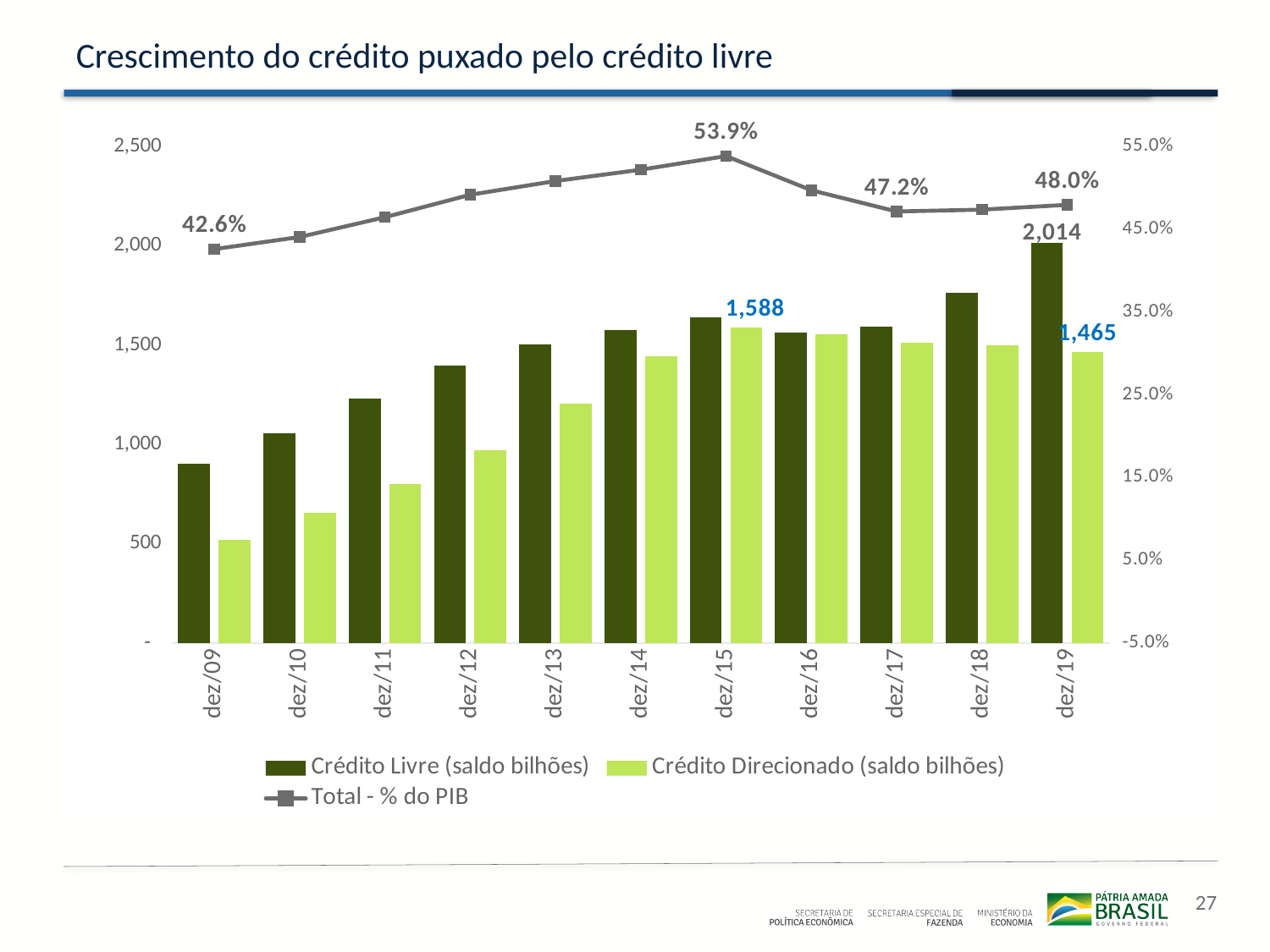
What is the Total - % do PIB value in dez/17? 47.2% In dez/19, which is larger: Crédito Livre or Crédito Direcionado? Crédito Livre What is the value of Crédito Livre (saldo bilhões) in dez/19? 2,014 What is the Total - % do PIB value in dez/09? 42.6% In which period does Total - % do PIB reach its highest value? dez/15 What is the value of Crédito Direcionado (saldo bilhões) in dez/15? 1,588 What kind of chart is shown on the slide? Combination bar and line chart What is the value of Crédito Direcionado (saldo bilhões) in dez/19? 1,465 How many series does the legend list? 3 What is the difference between Crédito Direcionado in dez/15 and in dez/19? 123 Is the value for Crédito Livre in dez/09 greater or less than 1,000? less How many periods are shown on the x axis? 11